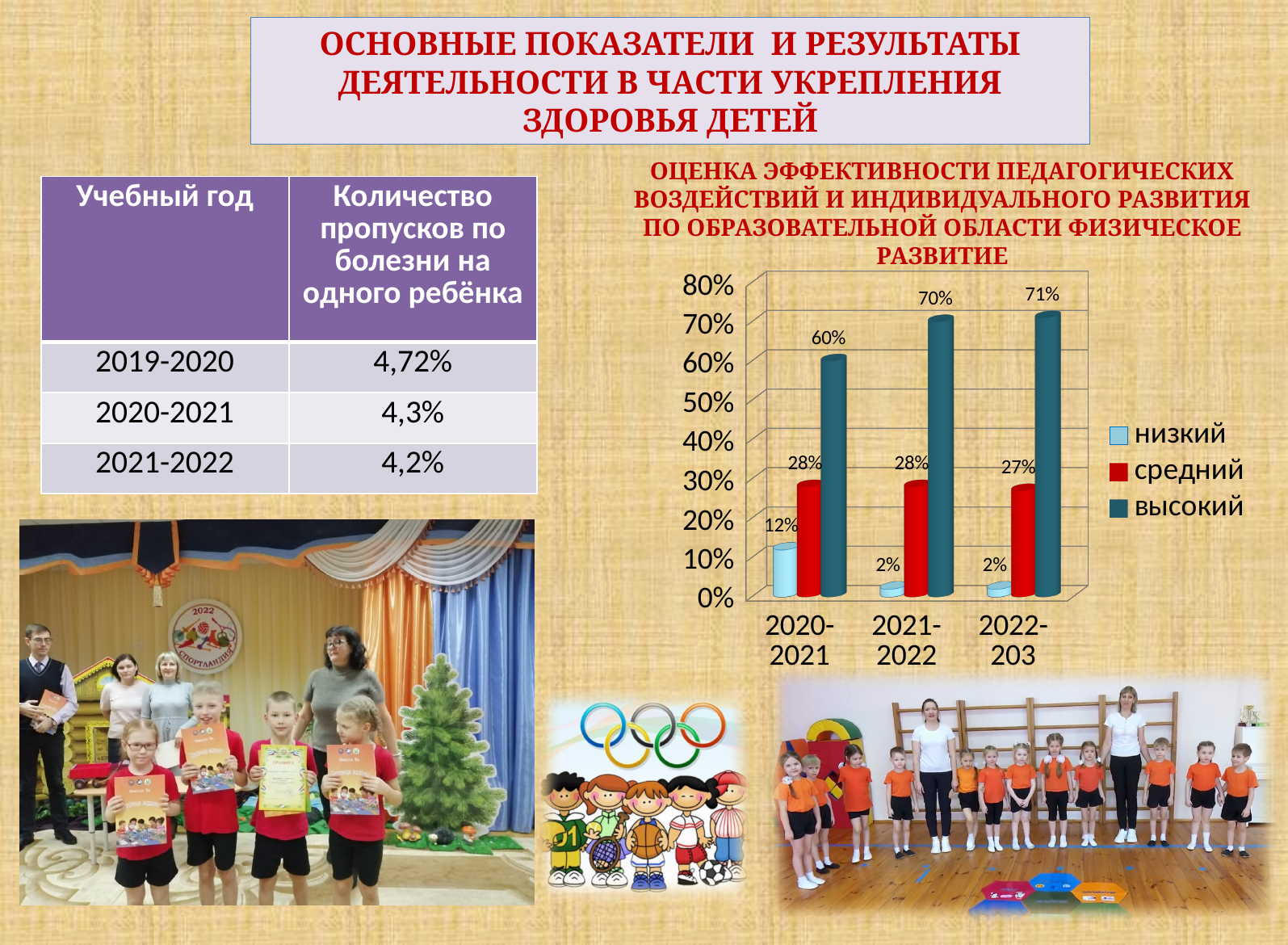
What kind of chart is shown on the slide? bar chart What is the value for средний in 2022-203? 27% In which category is the value for низкий the highest? 2020-2021 How many categories are shown on the x axis of the chart? 3 What is the value for высокий in 2020-2021? 60% What is the difference between the высокий values for 2022-203 and 2020-2021? 11% Does the value for высокий rise or fall from 2020-2021 to 2022-203? rise What is the value for низкий in 2020-2021? 12% What is the value for высокий in 2021-2022? 70% Which is larger: the средний value in 2020-2021 or the низкий value in 2020-2021? средний How many series does the chart legend list? 3 In which category is the value for высокий the highest? 2022-203